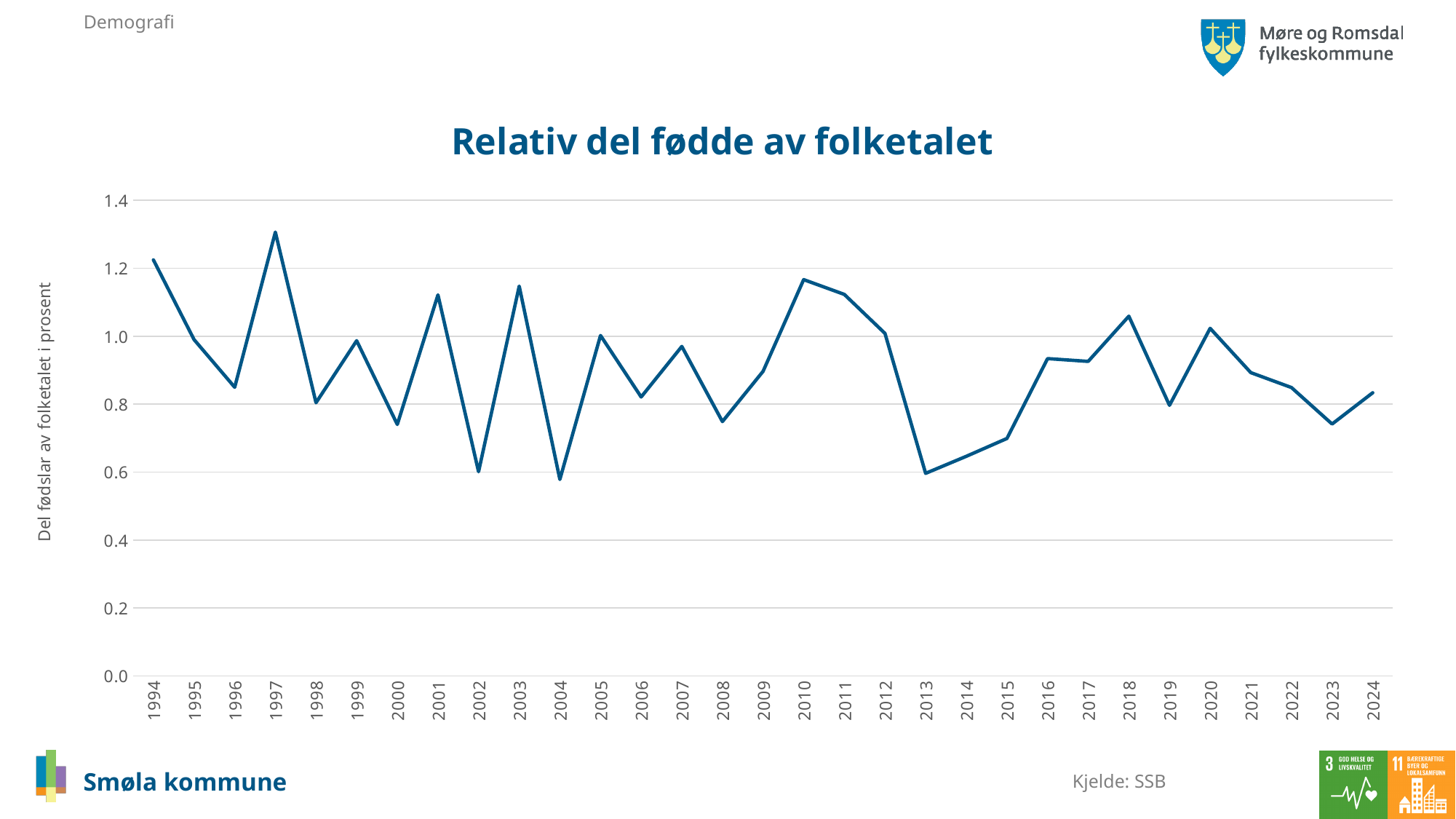
Which year has the highest value in the chart? 1997 Do the values rise or fall from 2010 to 2013? fall Is the value for 2000 greater or less than 0.8? less Is the value for 2013 greater or less than 0.8? less Which year has the larger value, 1994 or 1996? 1994 What kind of chart is shown on the slide? line chart What is the label on the vertical axis of the chart? Del fødslar av folketalet i prosent What is the title of the chart? Relativ del fødde av folketalet Is the value for 1997 greater or less than 1.2? greater How many years are plotted along the x axis of the chart? 31 Which year has the larger value, 2010 or 2013? 2010